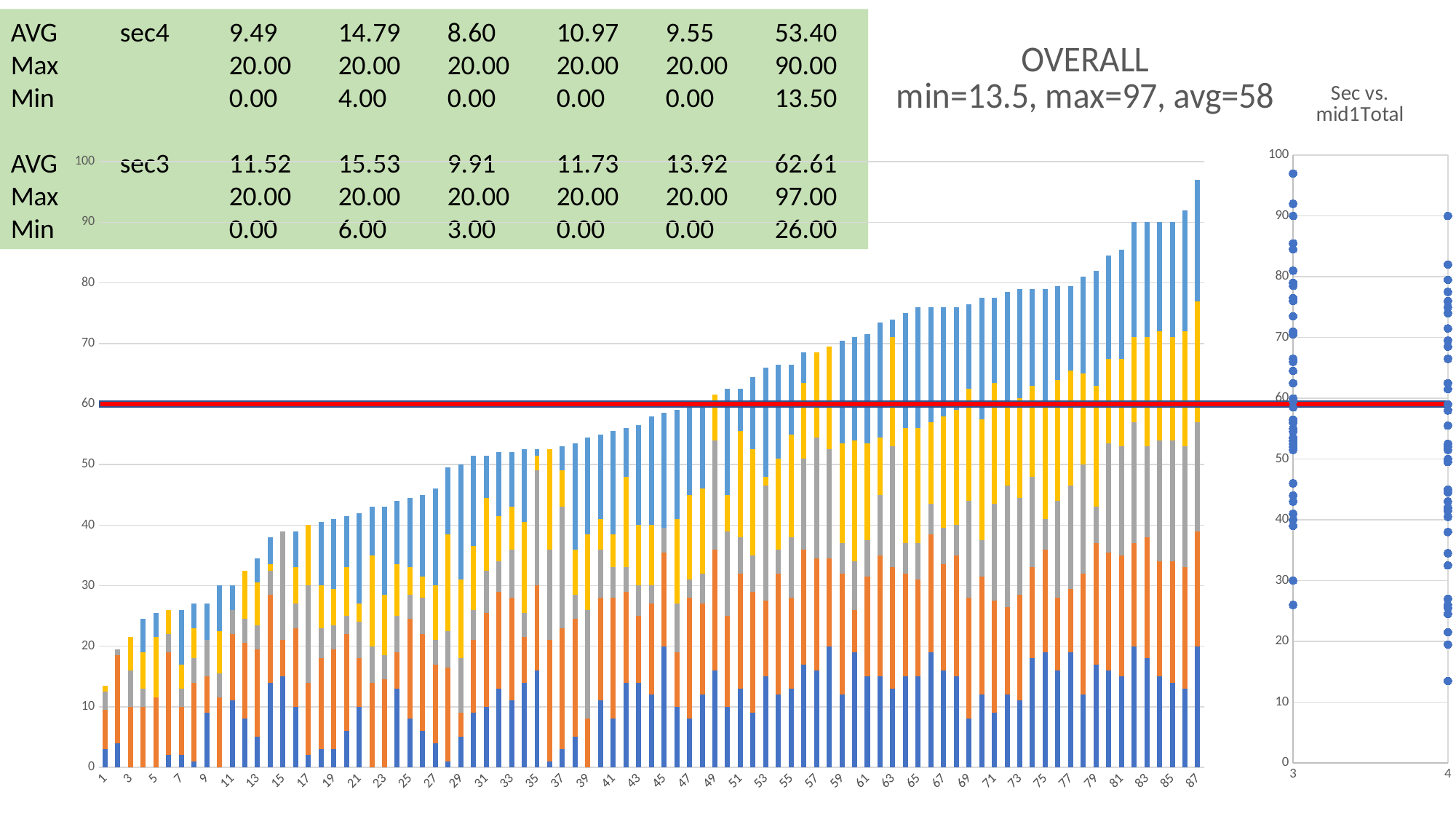
In the large stacked bar chart, is the total for bar 87 greater or less than 90? greater What is the title of the small chart on the right of the slide? Sec vs. mid1Total In the large stacked bar chart, do the bar totals rise or fall from left to right along the x axis? rise In the large stacked bar chart, at what y-axis value is the red horizontal line drawn? 60 In the 'Sec vs. mid1Total' scatter chart, is the lowest point at x = 4 greater or less than 20? less In the large stacked bar chart, is the total for bar 1 greater or less than 20? less In the large stacked bar chart, which bar has the lowest total? 1 What kind of chart is the small chart on the right titled 'Sec vs. mid1Total'? scatter chart In the large stacked bar chart, how many bars are plotted along the x axis? 87 What kind of chart is the large chart on the left of the slide? stacked bar chart In the large stacked bar chart, which bar has the highest total? 87